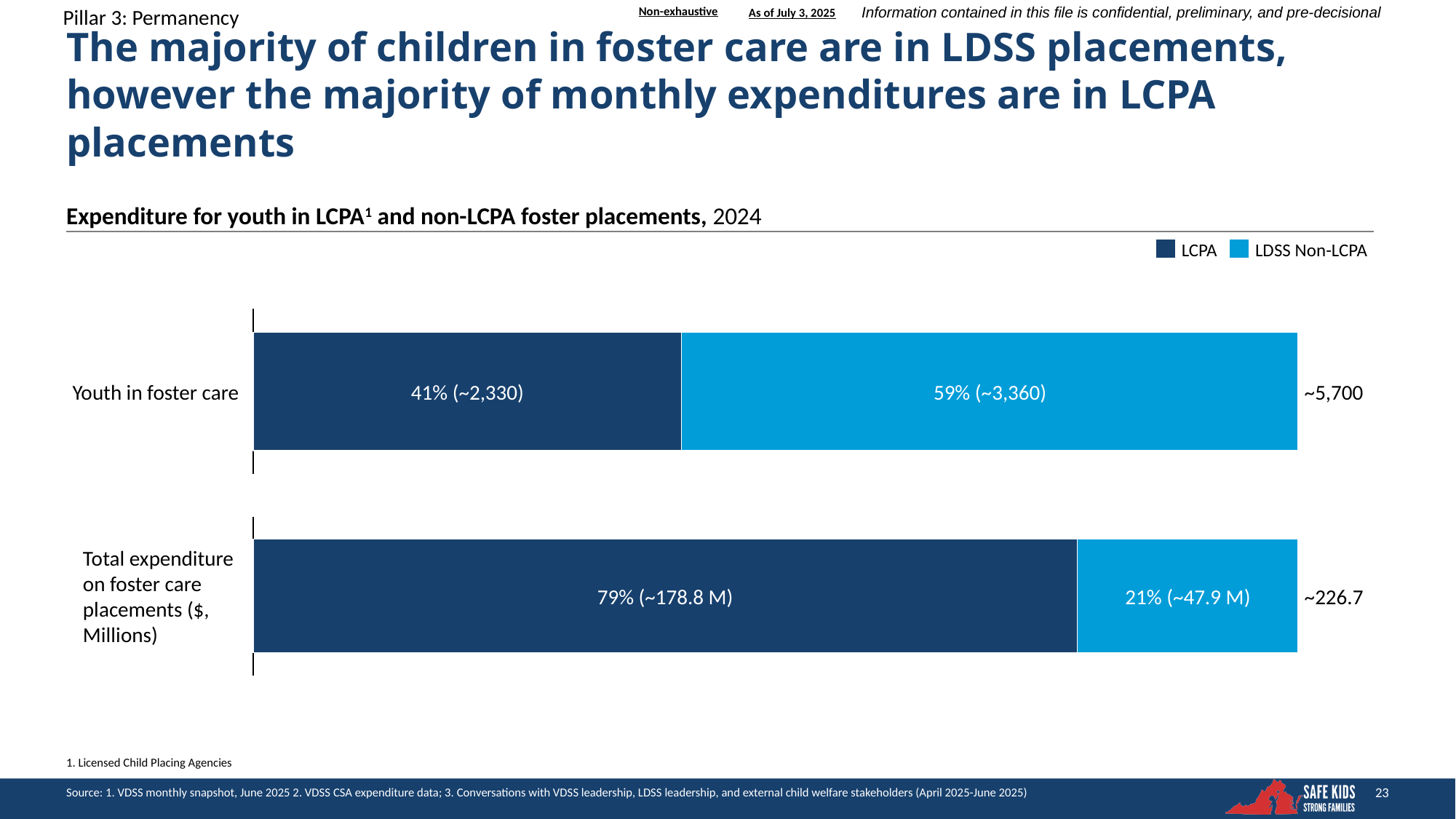
What percentage of youth in foster care are in LDSS Non-LCPA placements? 59% Which series is shown in the darker blue colour in the legend? LCPA For total expenditure on foster care placements, how many percentage points larger is the LCPA share than the LDSS Non-LCPA share? 58 percentage points What percentage of total expenditure on foster care placements goes to LDSS Non-LCPA placements? 21% How many series does the legend list? 2 What percentage of youth in foster care are in LCPA placements? 41% For youth in foster care, which series has the larger share: LCPA or LDSS Non-LCPA? LDSS Non-LCPA What total is printed at the end of the 'Youth in foster care' bar? ~5,700 What label is printed on the LCPA segment of the 'Total expenditure on foster care placements' bar? 79% (~178.8 M) What percentage of total expenditure on foster care placements goes to LCPA placements? 79% How many categories (bars) are plotted in the chart? 2 What kind of chart is shown on the slide? Stacked bar chart